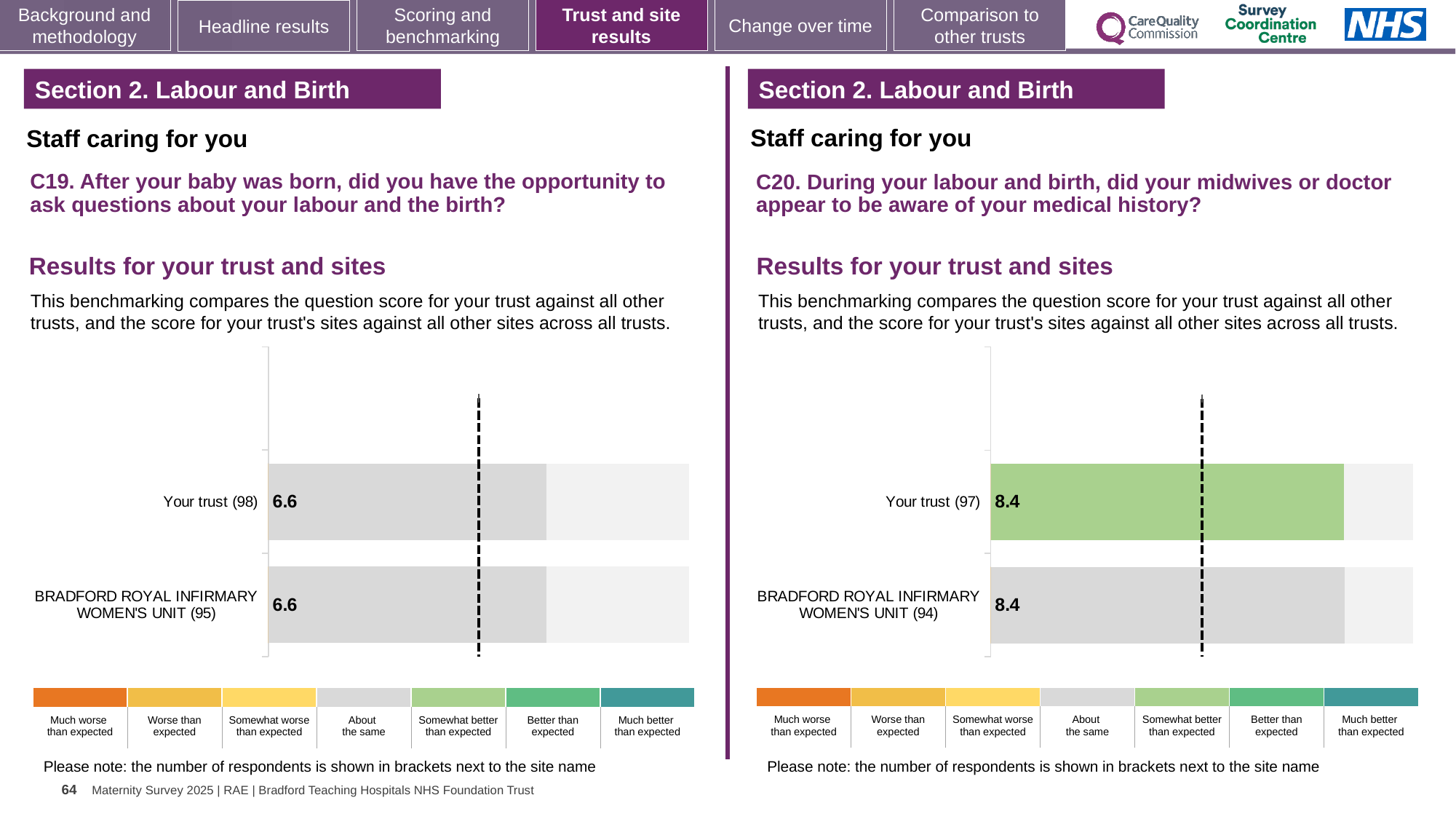
How many bars are plotted on the C19 chart (left)? 2 On the C19 chart (left), how many respondents are shown in brackets for Your trust? 98 How many bars are plotted on the C20 chart (right)? 2 On the C19 chart (left), what is the score for BRADFORD ROYAL INFIRMARY WOMEN'S UNIT? 6.6 On the C19 chart (left), what is the score for Your trust? 6.6 Is the score for Your trust on the C20 chart (right) larger or smaller than the score for Your trust on the C19 chart (left)? Larger On the C19 chart (left), what is the difference between the score for Your trust and the score for BRADFORD ROYAL INFIRMARY WOMEN'S UNIT? 0 On the C20 chart (right), what is the score for Your trust? 8.4 What kind of chart is the C20 chart (right)? Bar chart On the C20 chart (right), what is the difference between the score for Your trust and the score for BRADFORD ROYAL INFIRMARY WOMEN'S UNIT? 0 On the C20 chart (right), how many respondents are shown in brackets for BRADFORD ROYAL INFIRMARY WOMEN'S UNIT? 94 On the C20 chart (right), what is the score for BRADFORD ROYAL INFIRMARY WOMEN'S UNIT? 8.4